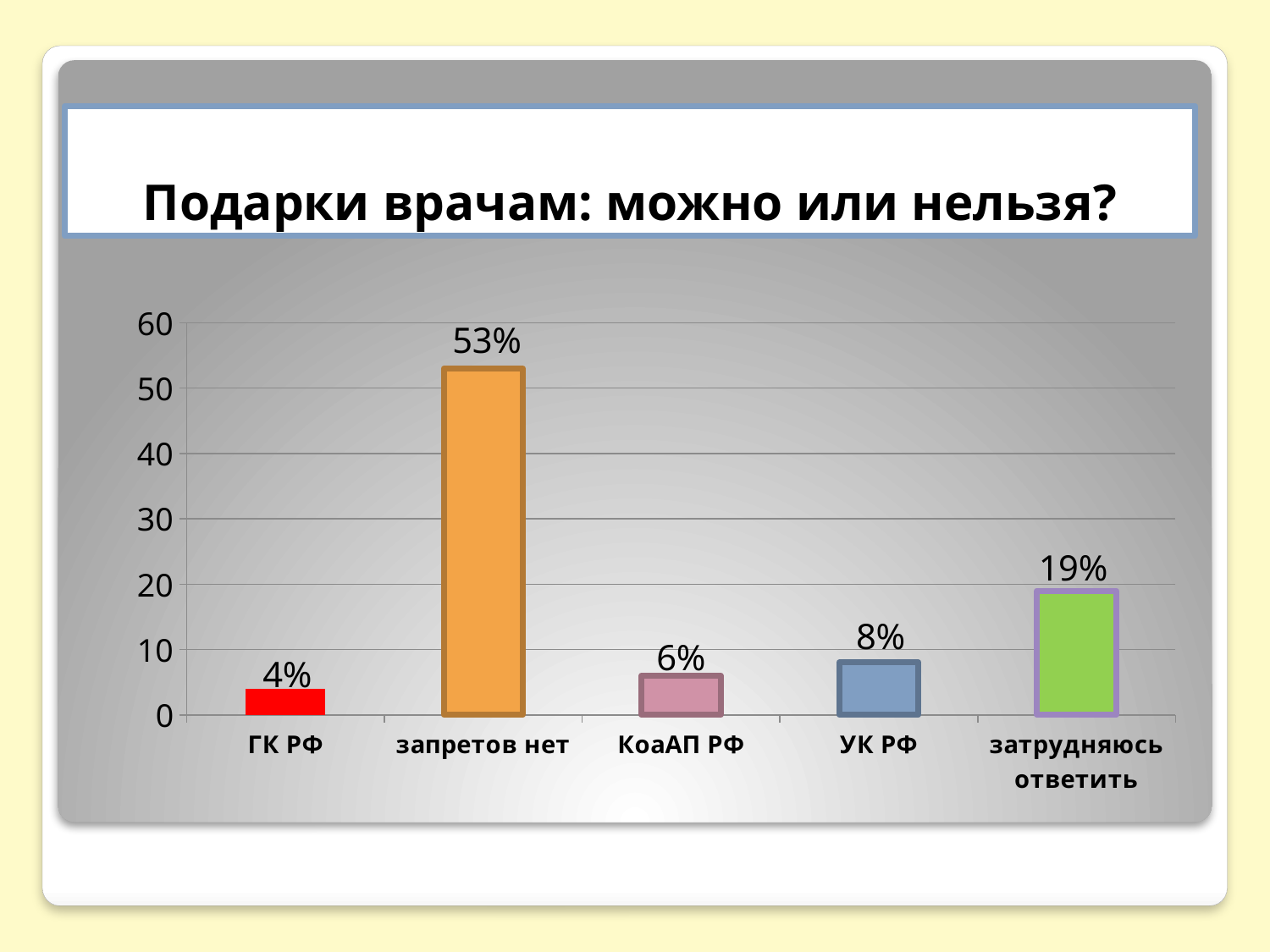
Which category has the highest value? запретов нет What is the value for "УК РФ"? 8% What is the value for "затрудняюсь ответить"? 19% What is the value for "ГК РФ"? 4% Which category has the lowest value? ГК РФ What is the title of the slide? Подарки врачам: можно или нельзя? How many categories are shown on the x axis? 5 Which is larger, the value for "КоаАП РФ" or the value for "УК РФ"? УК РФ What is the value for "запретов нет"? 53% What kind of chart is shown on the slide? bar chart Is the value for "затрудняюсь ответить" greater or less than 10? greater What is the difference between the values for "запретов нет" and "затрудняюсь ответить"? 34%